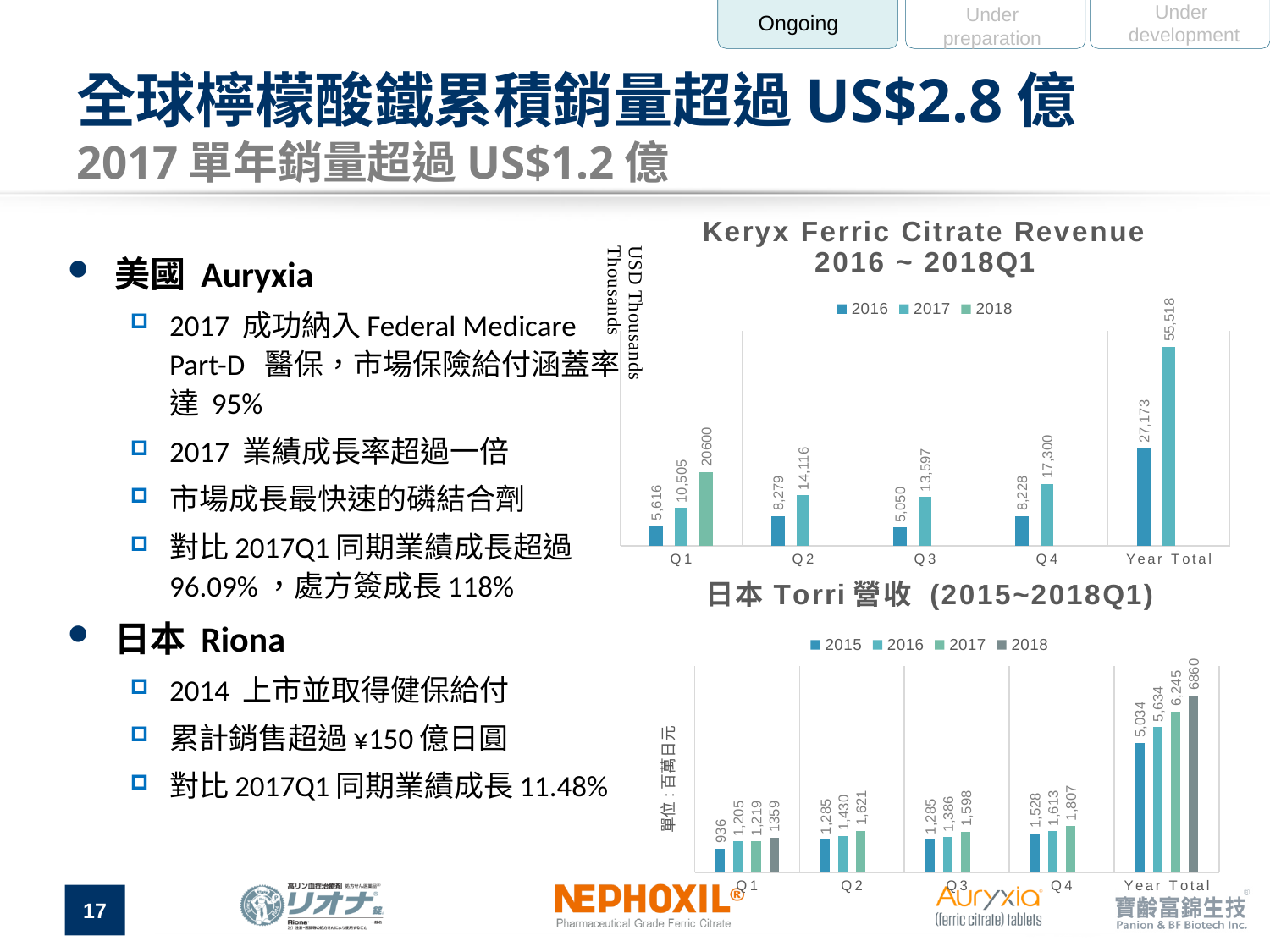
In the 日本 Torri 營收 chart, what is the difference between the 2017 and 2016 Year Total values? 611 In the Keryx Ferric Citrate Revenue chart, what is the 2018 value for Q1? 20600 In the 日本 Torri 營收 chart, which is larger for Q4: the 2017 value or the 2016 value? 2017 In the Keryx Ferric Citrate Revenue chart, what is the difference between the 2017 and 2016 Year Total values? 28,345 What type of chart is the Keryx Ferric Citrate Revenue chart? Bar chart In the 日本 Torri 營收 chart, what is the 2015 value for Q1? 936 In the Keryx Ferric Citrate Revenue chart, what is the 2017 value for Q4? 17,300 How many series does the legend of the 日本 Torri 營收 chart list? 4 In the 日本 Torri 營收 chart, what is the 2018 Year Total? 6860 In the Keryx Ferric Citrate Revenue chart, which quarter has the lowest 2016 value? Q3 How many series does the legend of the Keryx Ferric Citrate Revenue chart list? 3 In the Keryx Ferric Citrate Revenue chart, what is the 2016 Year Total? 27,173